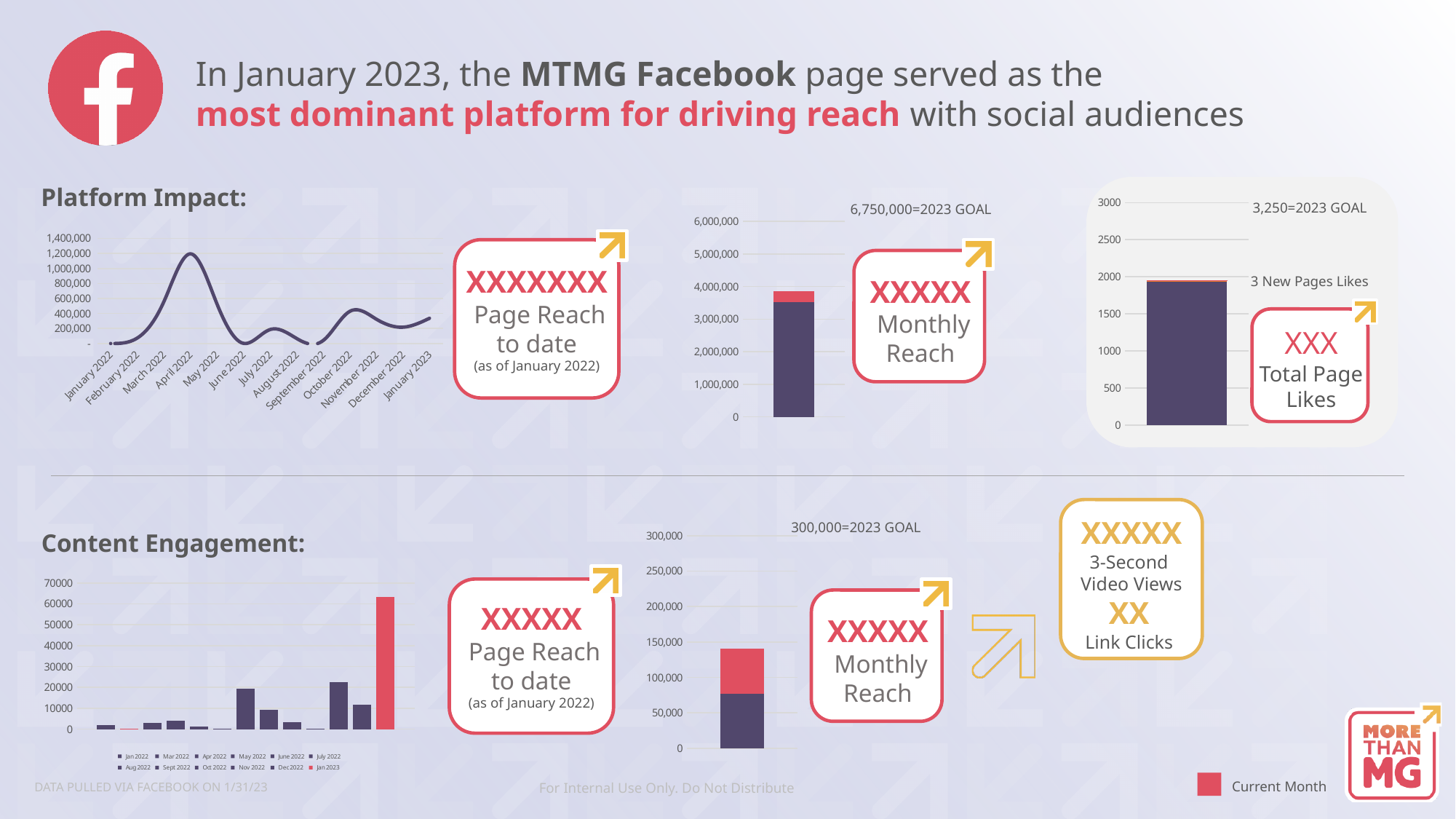
What is the 2023 goal shown on the Platform Impact Monthly Reach bar chart? 6,750,000 In the Platform Impact line chart, is the value for January 2023 greater or less than 600,000? less In the Content Engagement bar chart on the left, which month has the highest bar? Jan 2023 In the Platform Impact line chart, is the value for April 2022 greater or less than 1,000,000? greater How many months are plotted on the x axis of the Platform Impact line chart? 13 What is the 2023 goal shown on the Total Page Likes bar chart? 3,250 What kind of chart is the Platform Impact chart on the left showing January 2022 to January 2023? line chart In the Total Page Likes bar chart, is the bar greater or less than 1500? greater In the Platform Impact line chart, which month has the highest value? April 2022